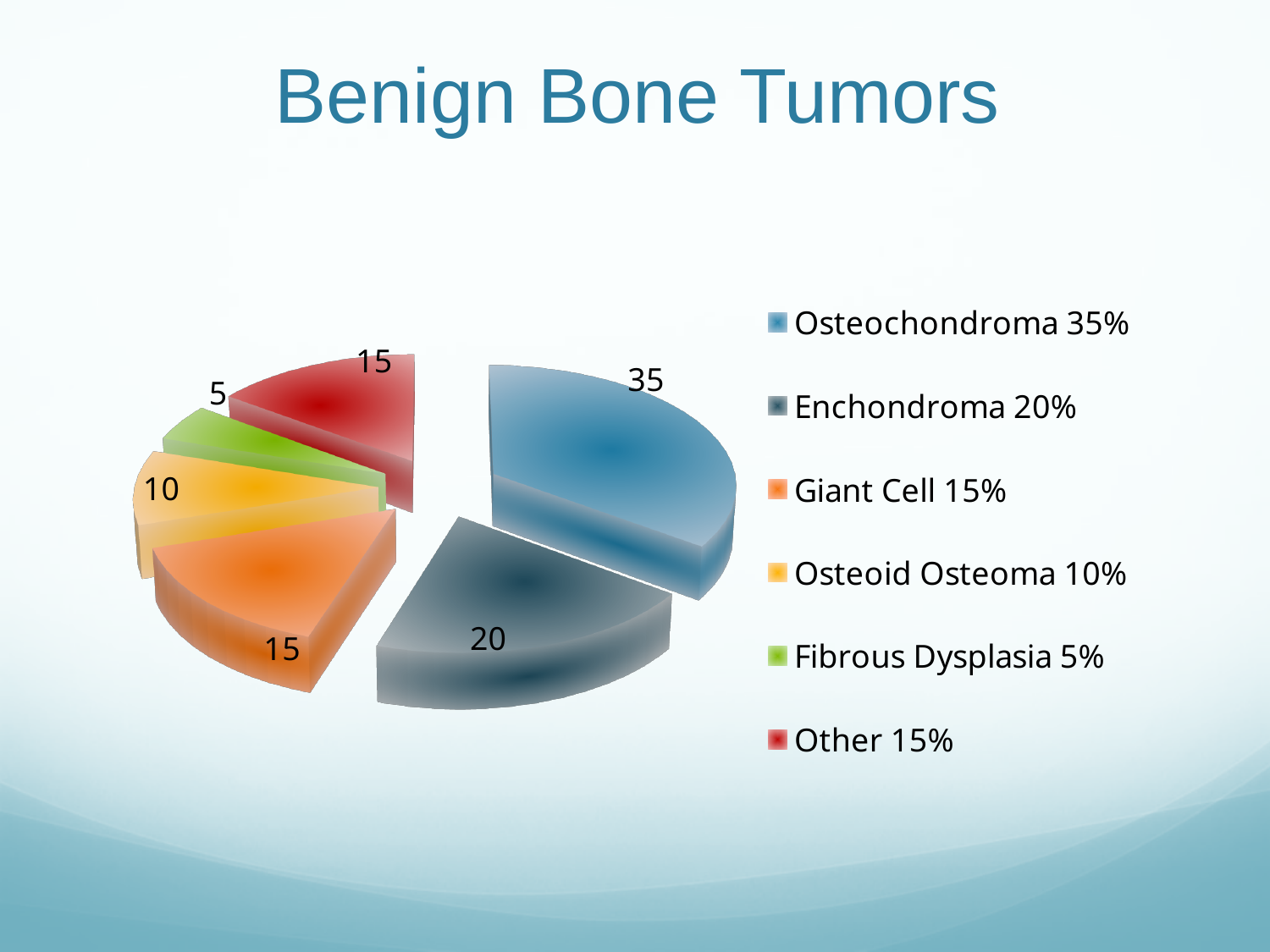
What is the title of the slide containing the chart? Benign Bone Tumors What is the value shown for Enchondroma? 20 What kind of chart is shown on the slide? pie chart Which category has the largest slice of the pie? Osteochondroma Which category has the smallest slice of the pie? Fibrous Dysplasia What is the value shown for Fibrous Dysplasia? 5 What share of the pie does Enchondroma represent, according to the legend? 20% Which is larger, the value for Giant Cell or the value for Osteoid Osteoma? Giant Cell What is the value shown for Osteochondroma? 35 How many categories does the pie chart have? 6 What is the value shown for Osteoid Osteoma? 10 What is the difference between the values for Osteochondroma and Enchondroma? 15